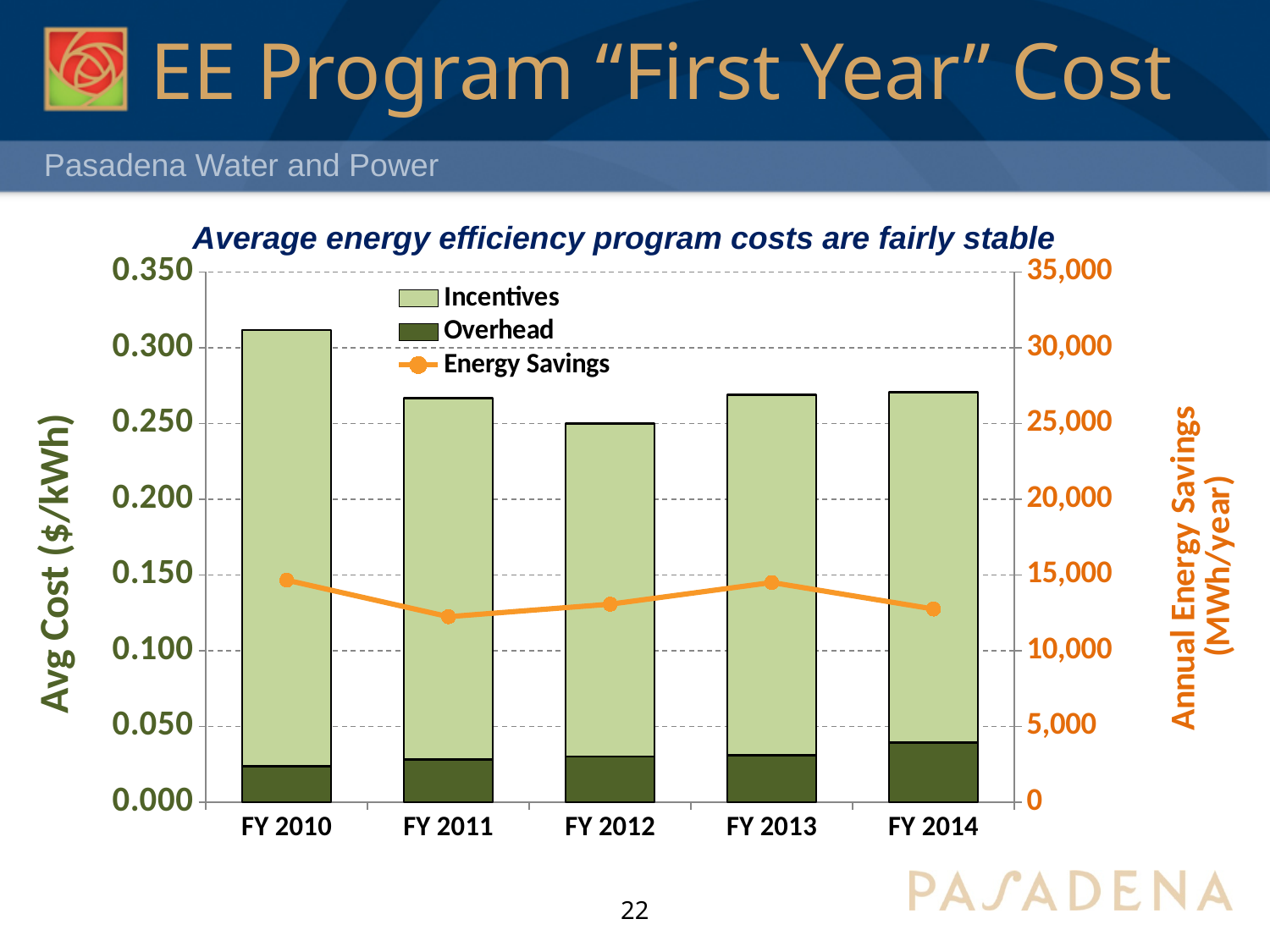
What kind of chart is shown on the slide? A stacked bar chart combined with a line Which fiscal year has the tallest stacked bar for average cost? FY 2010 How many fiscal years are shown on the x axis of the chart? 5 Is the Energy Savings value for FY 2011 greater or less than 15,000 MWh/year? less Which has the larger total average cost bar, FY 2010 or FY 2012? FY 2010 What is the label of the left vertical axis of the chart? Avg Cost ($/kWh) How many series does the chart legend list? 3 Which fiscal year has the shortest stacked bar for average cost? FY 2012 Is the total average cost bar for FY 2012 greater or less than 0.300 $/kWh? less Is the total average cost bar for FY 2010 greater or less than 0.300 $/kWh? greater Does the Energy Savings line rise or fall from FY 2010 to FY 2011? fall Which fiscal year has the largest Overhead segment? FY 2014